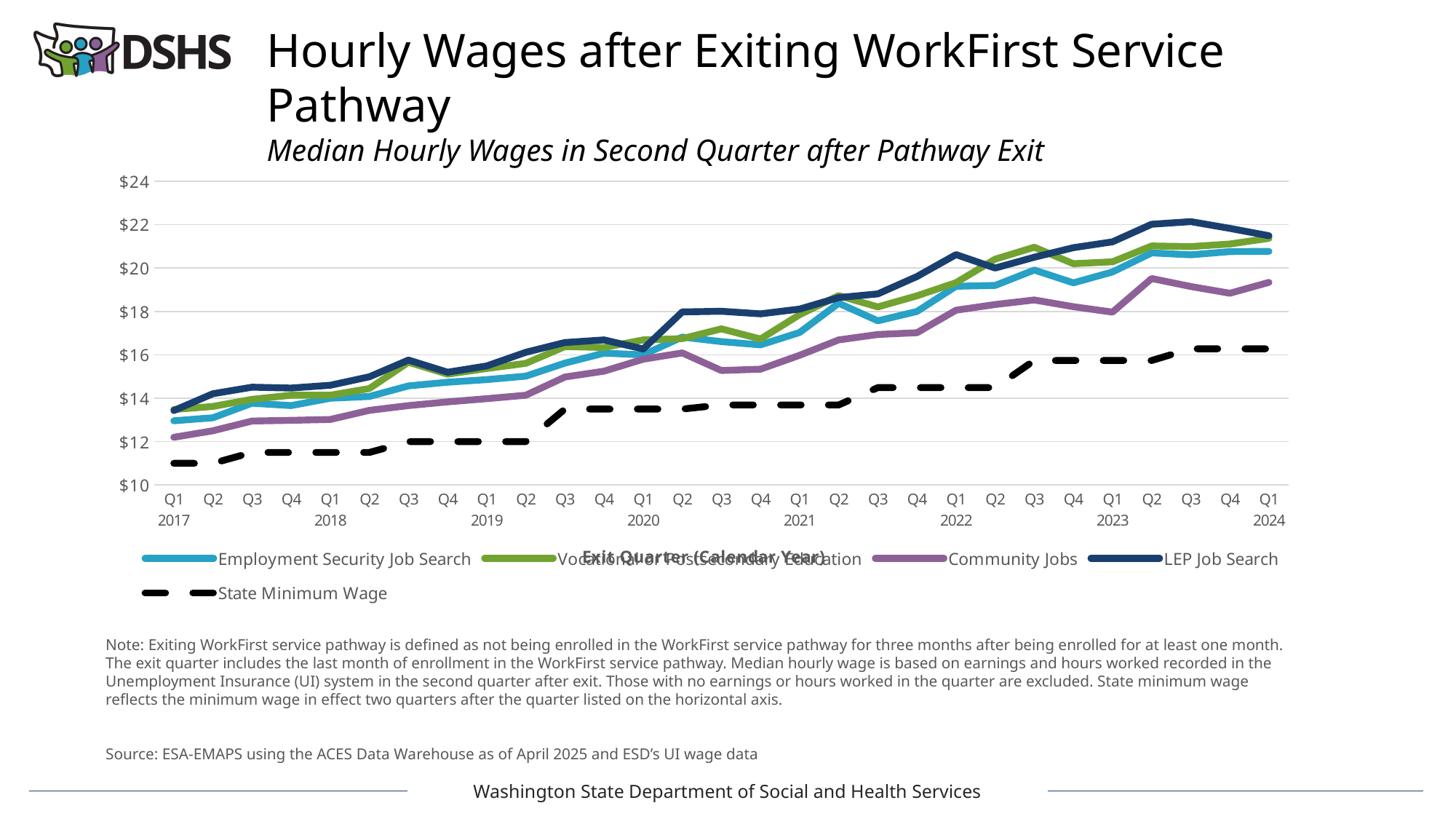
What kind of chart is shown on the slide? Line chart Is the value for Community Jobs in Q1 2024 greater or less than $20? less Is the value for State Minimum Wage in Q1 2017 greater or less than $12? less Is the value for LEP Job Search in Q1 2024 greater or less than $20? greater How many series does the legend list? 5 Do the median hourly wages for LEP Job Search generally rise or fall from Q1 2017 to Q1 2024? Rise Which series is drawn with a dashed black line? State Minimum Wage In Q1 2024, which is higher: LEP Job Search or Community Jobs? LEP Job Search Which series has the lowest value in Q1 2024? State Minimum Wage How many exit quarters are plotted along the x axis? 29 What is the subtitle of the chart? Median Hourly Wages in Second Quarter after Pathway Exit